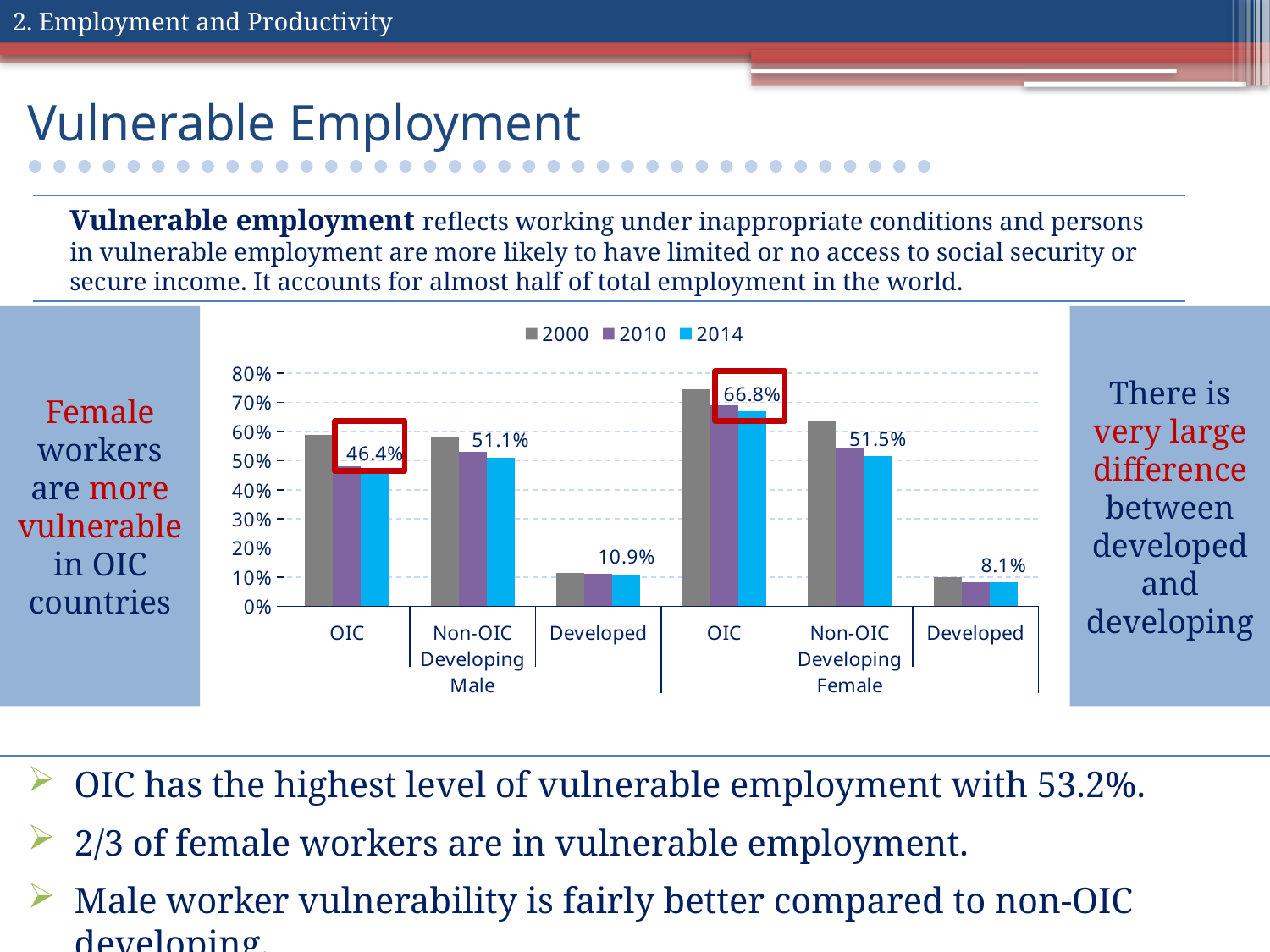
What is the 2014 vulnerable employment value for OIC in the Male group? 46.4% Which category has the lowest 2014 value in the chart? Developed (Female) What is the 2014 value for OIC in the Female group? 66.8% What is the 2014 value for Developed countries in the Male group? 10.9% What is the 2014 value for Developed countries in the Female group? 8.1% What is the 2014 value for Non-OIC Developing in the Female group? 51.5% Is the 2000 value for OIC in the Female group greater or less than 70%? greater What is the difference between the 2014 values for OIC Female and OIC Male? 20.4% Which category has the highest 2014 value in the chart? OIC (Female) How many series does the legend list? 3 Which is larger in 2014: Non-OIC Developing Male or OIC Male? Non-OIC Developing Male What type of chart is shown on the slide? Bar chart